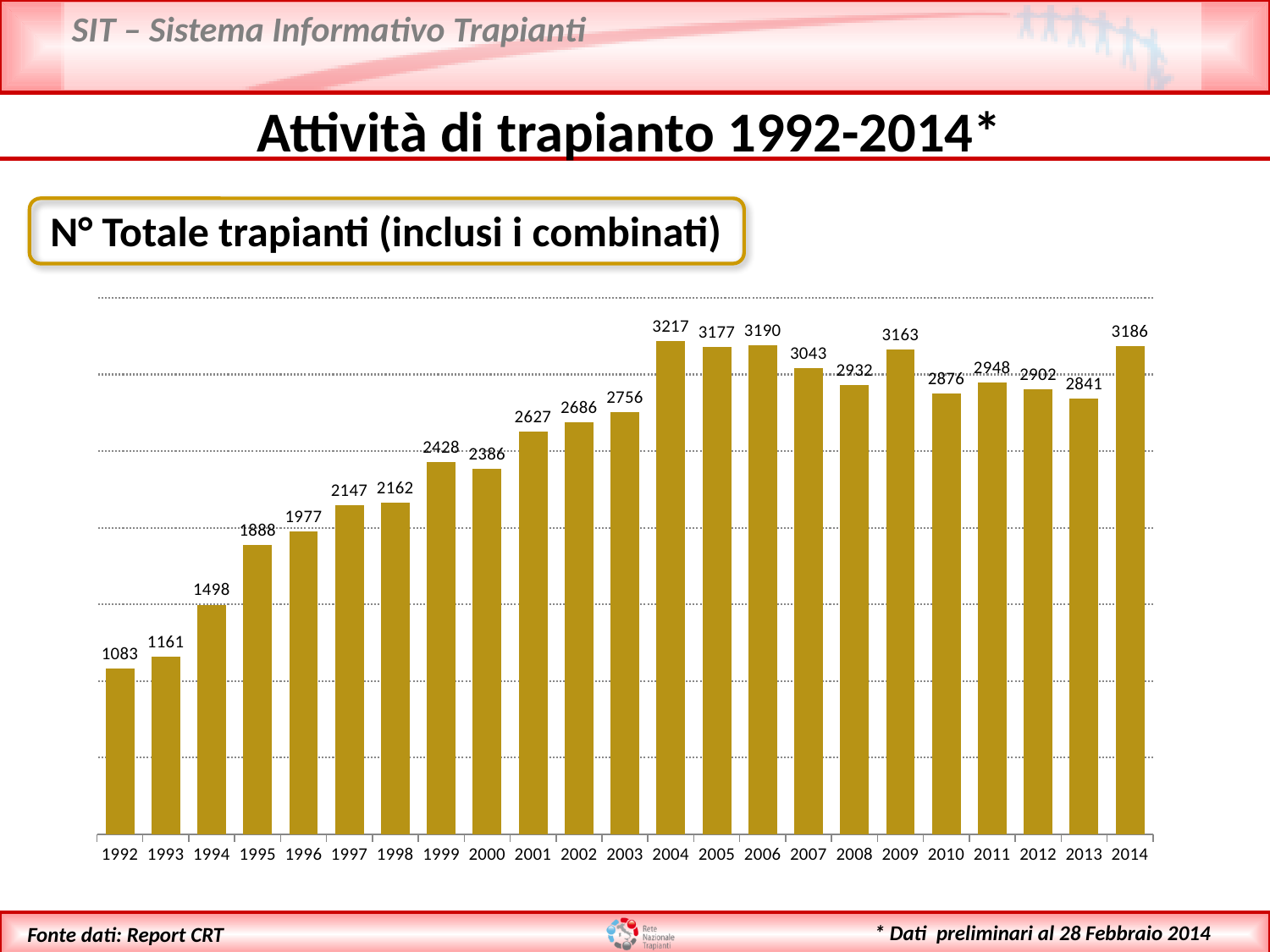
Which year has the lowest value? 1992 What is the difference between the values for 2014 and 2013? 345 What is the value for 2000? 2386 What kind of chart is shown on the slide? bar chart What is the difference between the values for 2004 and 1992? 2134 What is the value for 1992? 1083 What is the value for 2014? 3186 Which is larger, the value for 2006 or the value for 2005? 2006 Which year has the highest value? 2004 Do the values rise or fall from 1992 to 2004? rise What is the value for 2004? 3217 How many years are shown on the x axis? 23